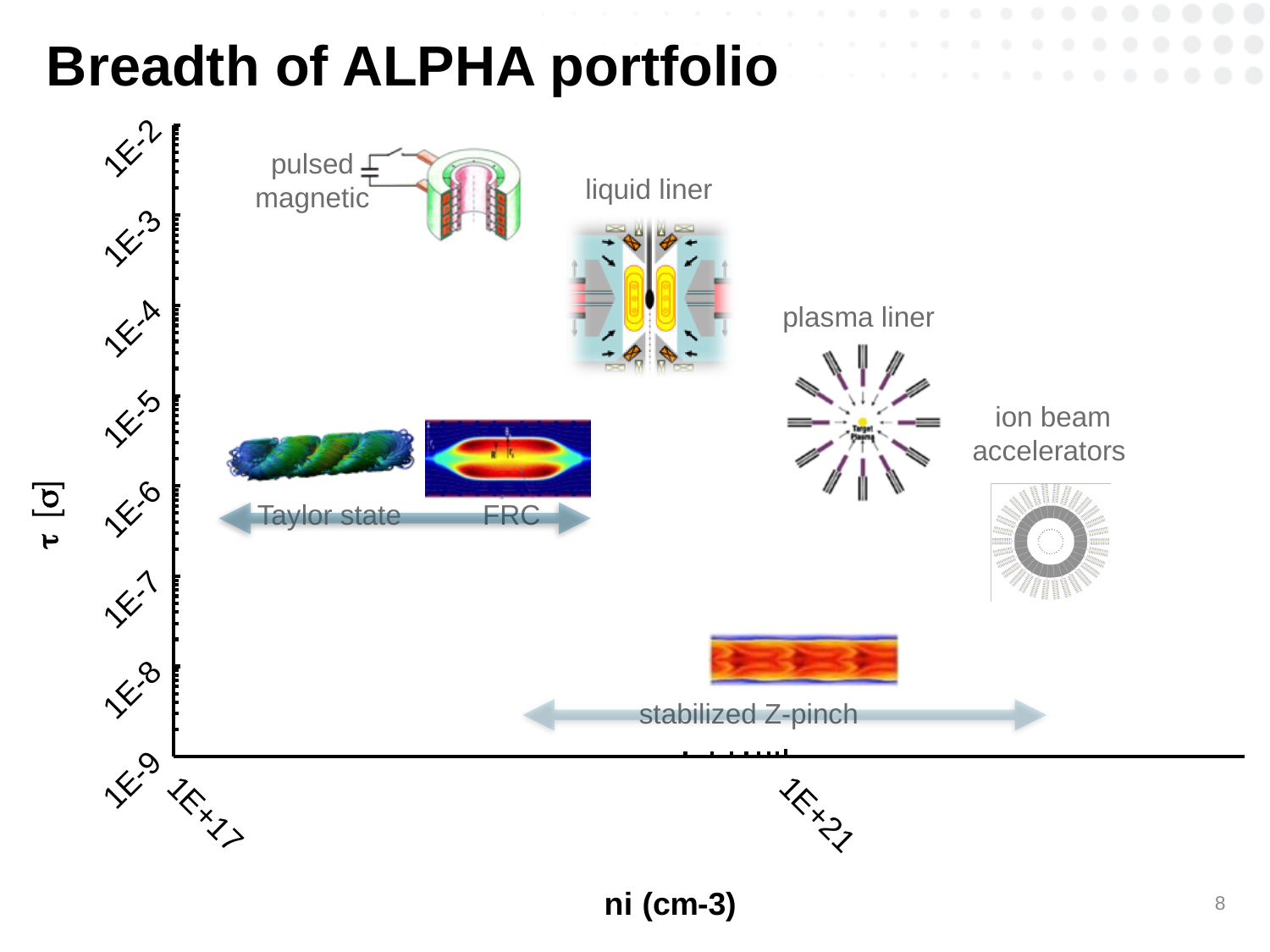
Is the Taylor state / FRC arrow positioned at a τ greater or less than 1E-5? less Which is placed at a higher τ on the chart, pulsed magnetic or stabilized Z-pinch? pulsed magnetic Is the pulsed magnetic concept positioned at a τ greater or less than 1E-4? greater Which is placed at a higher ni on the chart, Taylor state or stabilized Z-pinch? stabilized Z-pinch How many named concepts are labelled on the chart? 7 Is the Taylor state / FRC arrow positioned at an ni greater or less than 1E+21? less What is the title of the y axis of the chart? τ [σ] What is the title of the x axis of the chart? ni (cm-3) Which is placed at a higher τ on the chart, liquid liner or ion beam accelerators? liquid liner